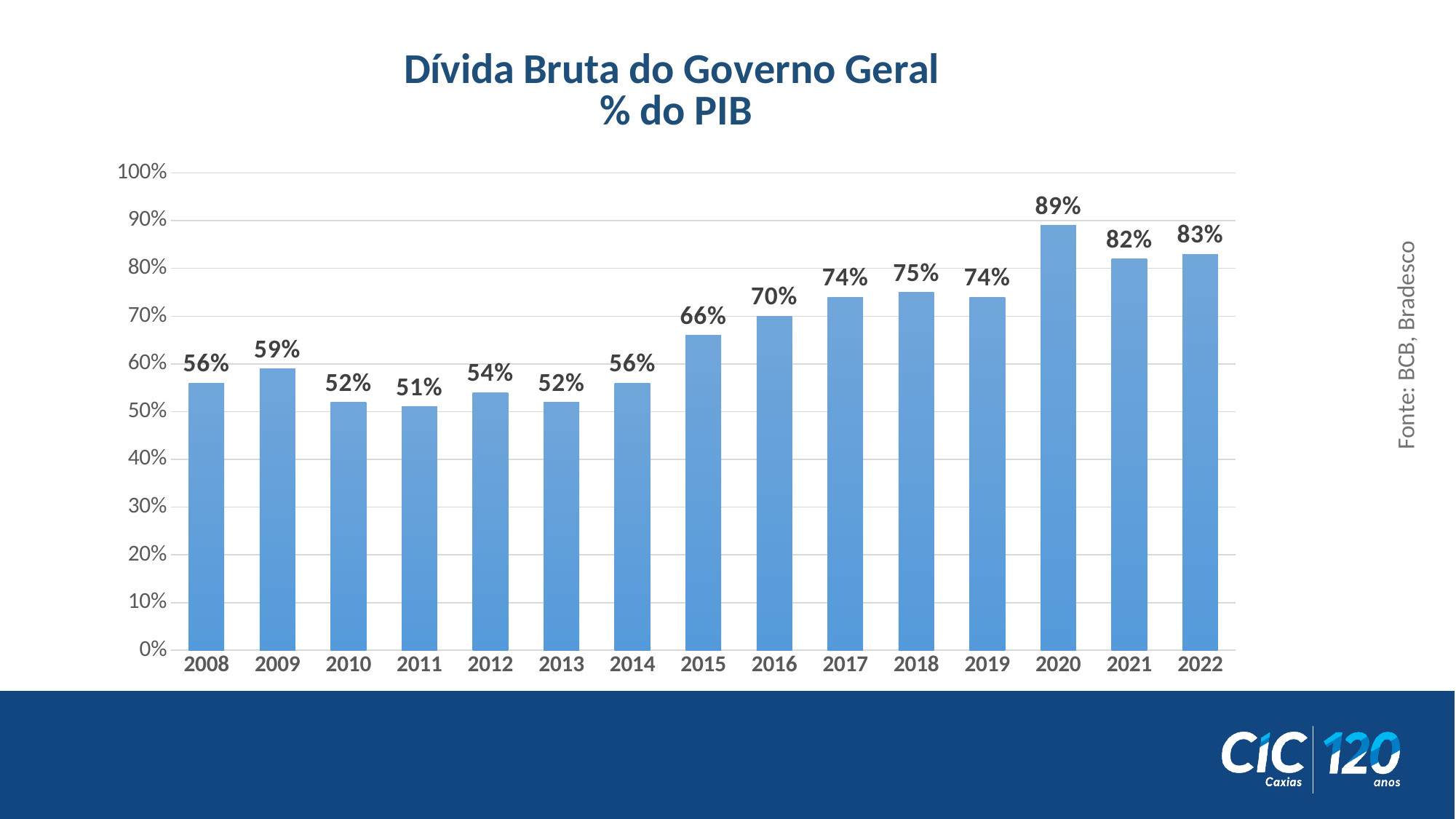
Which year has the lowest value? 2011 What kind of chart is this? bar chart Which year has the highest value? 2020 What is the value for 2015? 66% What is the value for 2011? 51% Which is larger, the value for 2009 or the value for 2014? 2009 Is the value for 2016 greater or less than 60%? greater What is the difference between the values for 2020 and 2019? 15% What is the difference between the values for 2022 and 2008? 27% What is the title of the chart? Dívida Bruta do Governo Geral % do PIB How many years are shown on the x axis? 15 What is the value for 2020? 89%